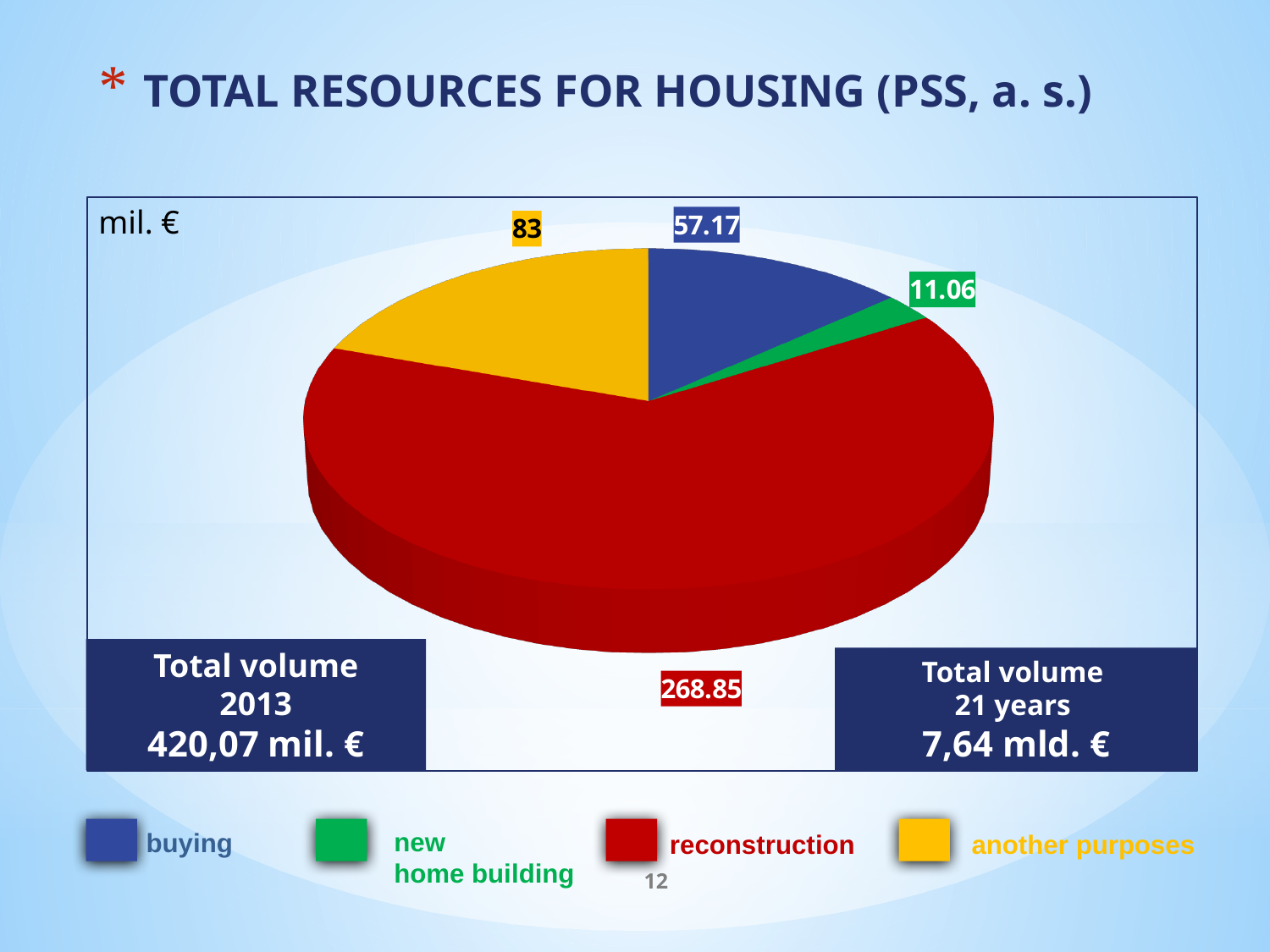
How many categories does the pie chart have? 4 What kind of chart is shown on the slide? pie chart Which is larger, the value for another purposes or the value for buying? another purposes What is the value for new home building? 11.06 Which category has the largest slice of the pie? reconstruction What is the difference between the values for buying and new home building? 46.11 What is the value for another purposes? 83 What is the difference between the values for reconstruction and another purposes? 185.85 What is the value for buying? 57.17 What is the value for reconstruction? 268.85 Which category has the smallest slice of the pie? new home building What unit is shown in the top-left corner of the chart area? mil. €